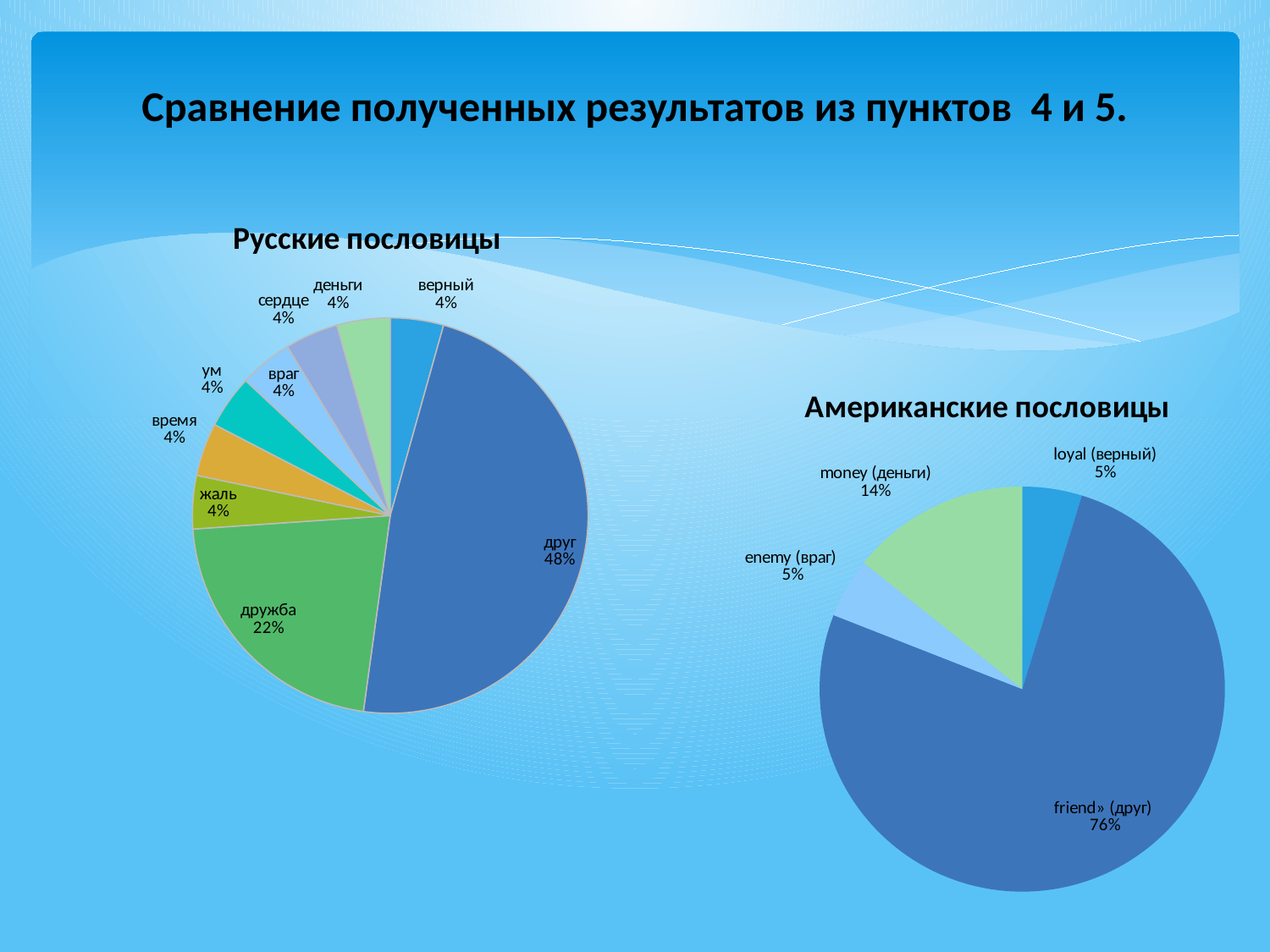
In the 'Русские пословицы' chart, which category has the largest share? друг In the 'Русские пословицы' chart, how many slices does the pie have? 9 In the 'Американские пословицы' chart, how many slices does the pie have? 4 What is the title of the chart on the right side of the slide? Американские пословицы In the 'Американские пословицы' chart, which category has the largest share? friend» (друг) What kind of chart is the 'Русские пословицы' chart? pie chart In the 'Русские пословицы' chart, what share does 'дружба' have? 22% In the 'Русские пословицы' chart, what is the difference between the shares of 'друг' and 'дружба'? 26% In the 'Русские пословицы' chart, what share does 'друг' have? 48% In the 'Американские пословицы' chart, what share does 'money (деньги)' have? 14% In the 'Американские пословицы' chart, which is larger: 'money (деньги)' or 'enemy (враг)'? money (деньги) In the 'Американские пословицы' chart, what share does 'friend» (друг)' have? 76%